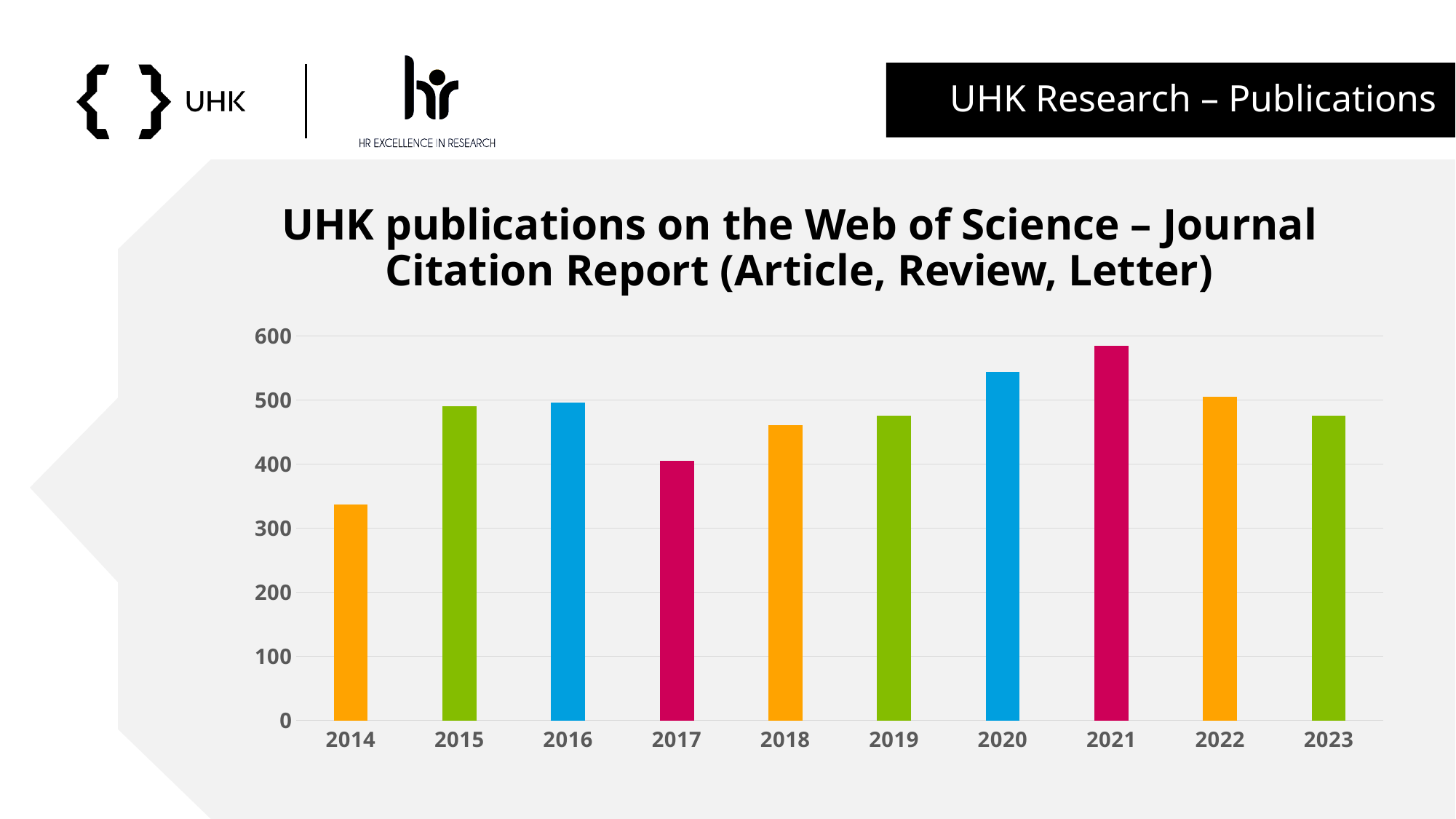
Which year has the highest number of publications? 2021 What kind of chart is shown on the slide? bar chart Which year has the lowest number of publications? 2014 What is the title of the chart? UHK publications on the Web of Science – Journal Citation Report (Article, Review, Letter) Do the values rise or fall from 2021 to 2023? fall Which year has more publications, 2022 or 2018? 2022 Is the value for 2020 greater or less than 500? greater Is the value for 2021 greater or less than 500? greater Which year has more publications, 2020 or 2017? 2020 Is the value for 2017 greater or less than 500? less How many years are shown on the x axis of the chart? 10